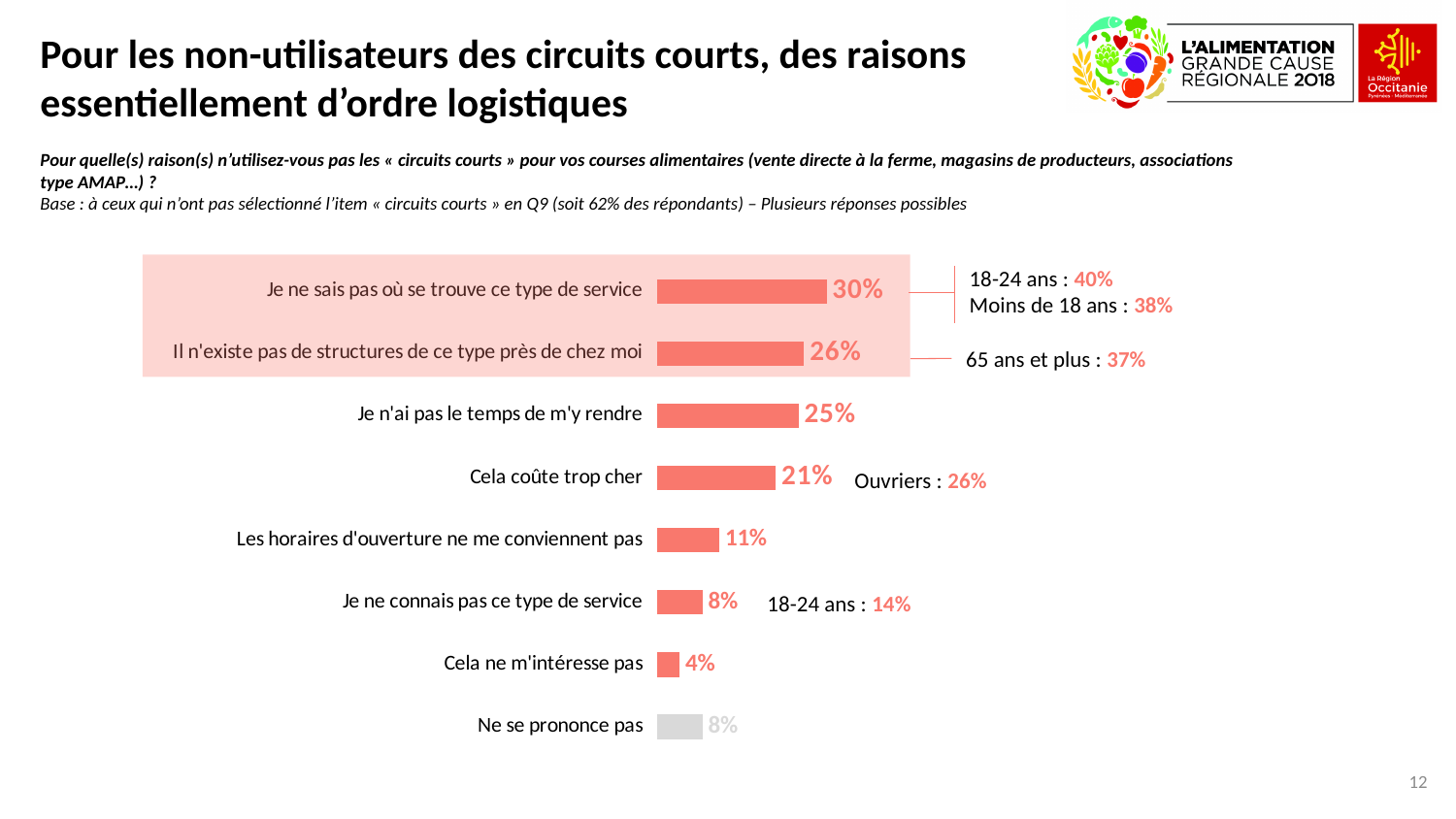
Which category has the lowest value? Cela ne m'intéresse pas What is the value for "Cela coûte trop cher"? 21% What is the value for "Ne se prononce pas"? 8% What is the value shown for "18-24 ans" next to the bar "Je ne sais pas où se trouve ce type de service"? 40% What is the difference between "Je ne sais pas où se trouve ce type de service" and "Il n'existe pas de structures de ce type près de chez moi"? 4 percentage points What is the value for "Les horaires d'ouverture ne me conviennent pas"? 11% How many categories are shown in the chart? 8 What is the value for "Je ne sais pas où se trouve ce type de service"? 30% What is the difference between "Je n'ai pas le temps de m'y rendre" and "Cela coûte trop cher"? 4 percentage points What kind of chart is shown on the slide? Bar chart Which is larger: "Les horaires d'ouverture ne me conviennent pas" or "Je ne connais pas ce type de service"? Les horaires d'ouverture ne me conviennent pas Which category has the highest value? Je ne sais pas où se trouve ce type de service